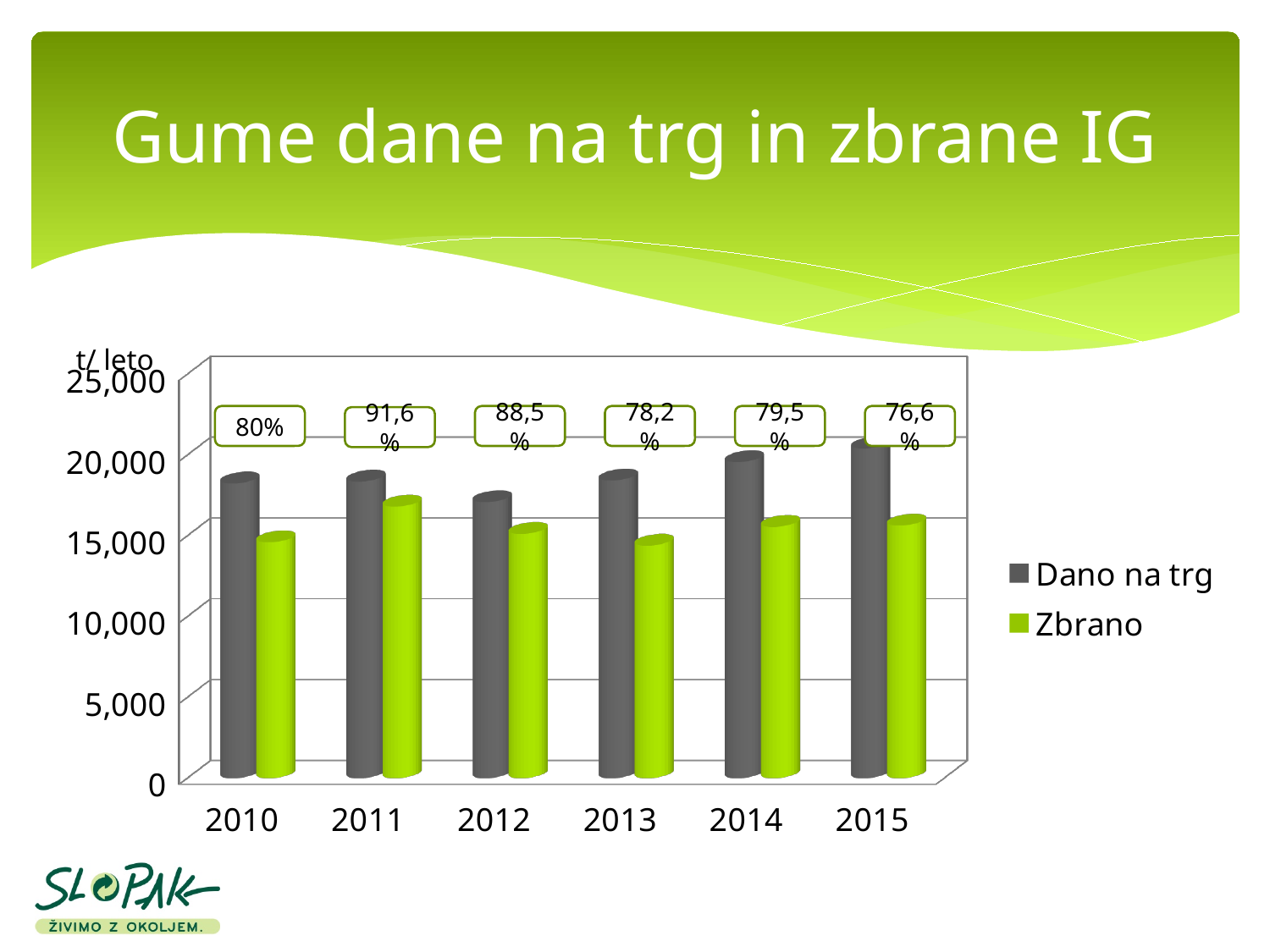
What percentage label is shown above the bars for 2011? 91,6% Is the 'Dano na trg' value for 2012 greater or less than 20,000? less How many years are shown on the x axis? 6 In which year is the 'Dano na trg' bar the highest? 2015 Is the 'Zbrano' value for 2011 greater or less than 15,000? greater Which is larger in 2013, 'Dano na trg' or 'Zbrano'? Dano na trg What kind of chart is shown on the slide? bar chart How many series does the legend list? 2 In which year is the 'Dano na trg' bar the lowest? 2012 In which year is the 'Zbrano' bar the highest? 2011 What percentage label is shown above the bars for 2015? 76,6% What percentage label is shown above the bars for 2010? 80%